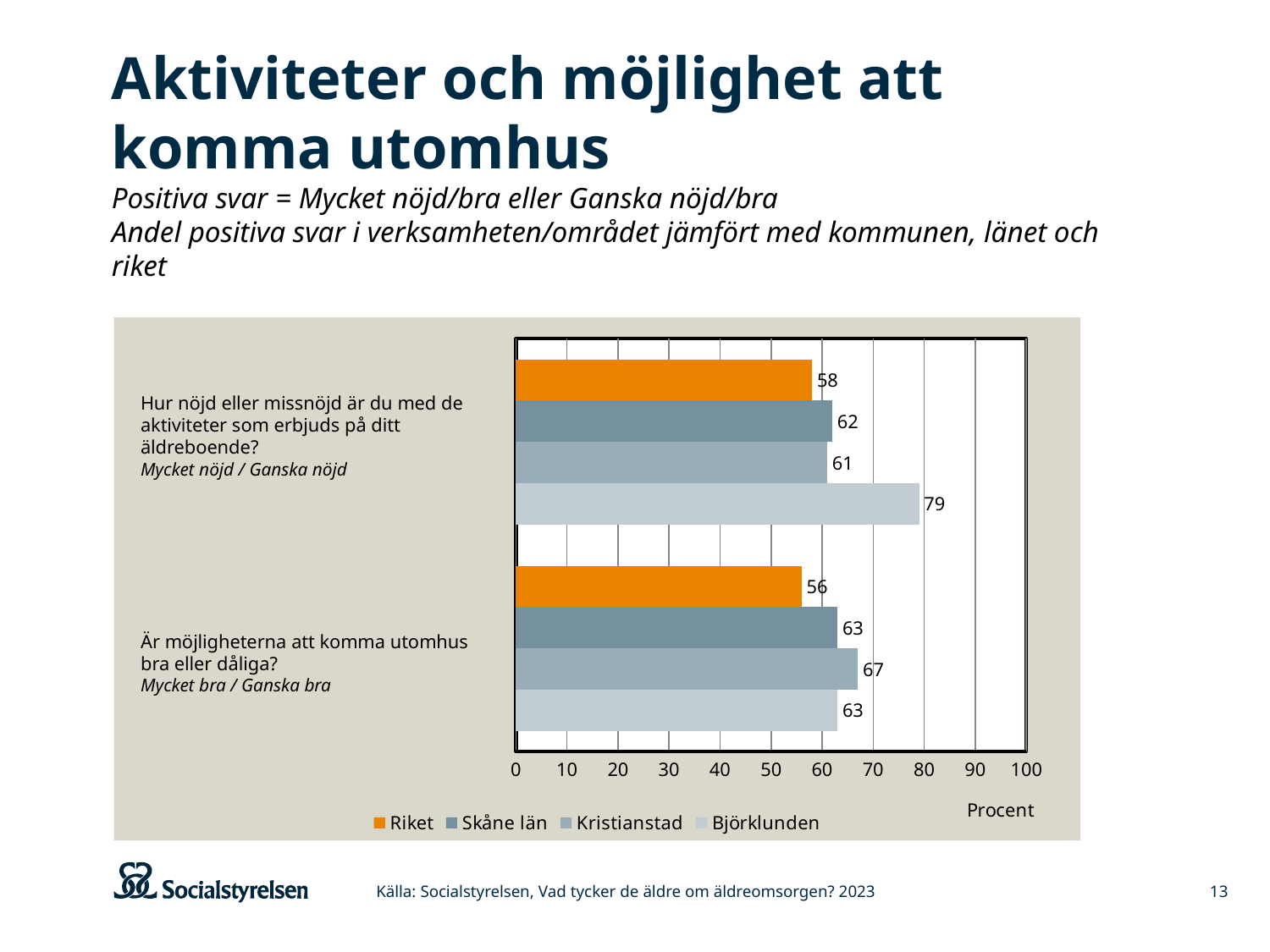
What is the value for Kristianstad for the question about opportunities to get outdoors? 67 What unit label is shown below the x axis of the chart? Procent How many series does the legend list? 4 What is the value for Skåne län for the question about satisfaction with activities offered? 62 What is the value for Björklunden for the question about satisfaction with activities offered at the care home (Hur nöjd eller missnöjd är du med de aktiviteter som erbjuds på ditt äldreboende)? 79 Which is larger for the question about opportunities to get outdoors: Kristianstad or Skåne län? Kristianstad What is the value for Riket for the question about opportunities to get outdoors (Är möjligheterna att komma utomhus bra eller dåliga)? 56 Which series has the highest value for the question about satisfaction with activities offered? Björklunden What is the difference between Kristianstad and Riket for the question about opportunities to get outdoors? 11 What is the difference between Björklunden and Riket for the question about satisfaction with activities offered? 21 What kind of chart is shown on the slide? Bar chart Which series has the lowest value for the question about opportunities to get outdoors? Riket